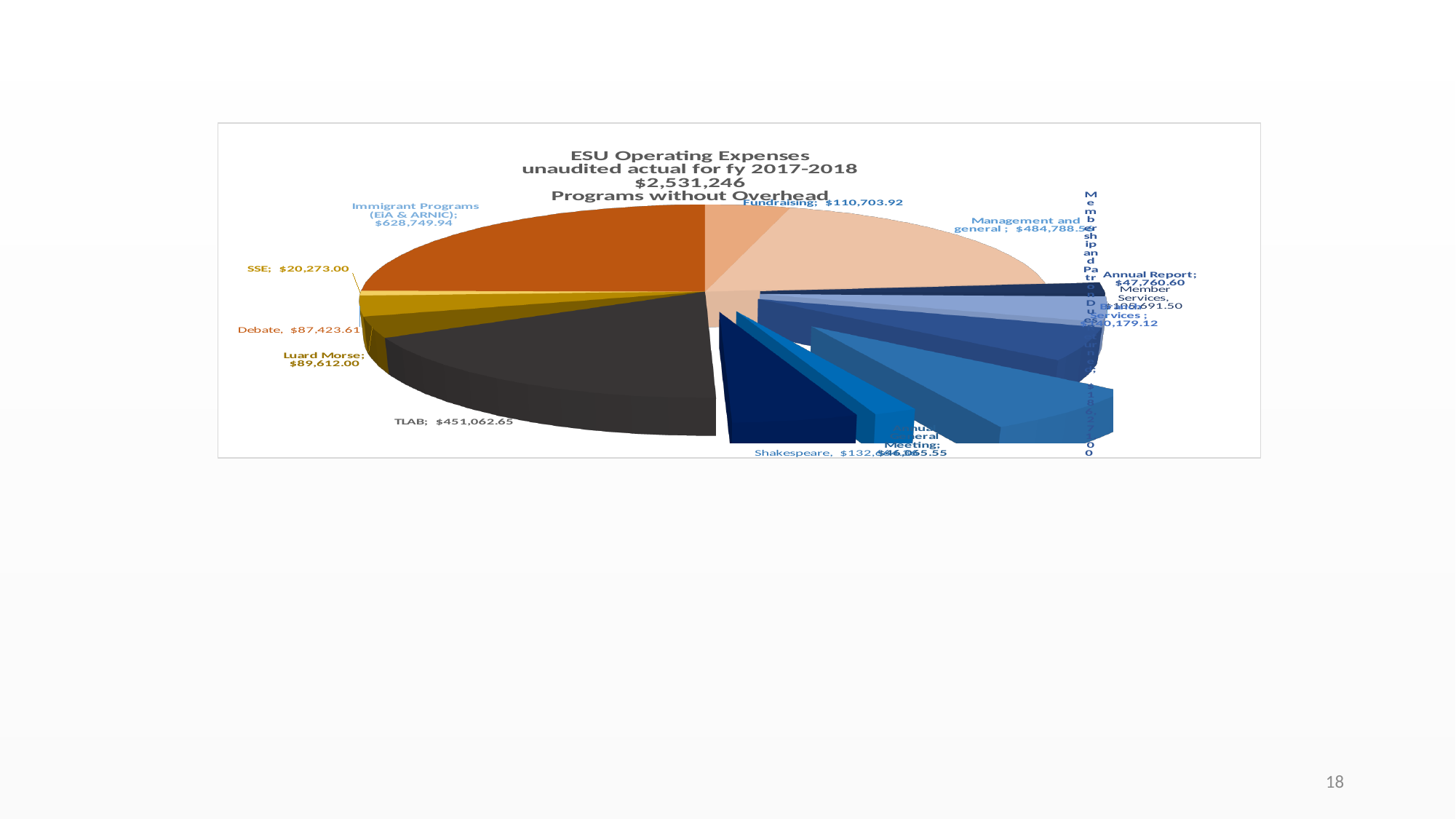
What total amount is stated in the chart title? $2,531,246 What is the value for Annual Report? $47,760.60 What is the value for Luard Morse? $89,612.00 Which category has the largest slice of the pie? Immigrant Programs (EiA & ARNIC) What kind of chart is shown on the slide? Pie chart What is the value for TLAB? $451,062.65 What is the difference between Immigrant Programs (EiA & ARNIC) and TLAB? $177,687.29 What is the value for Debate? $87,423.61 Which is larger, TLAB or Fundraising? TLAB What is the value for Fundraising? $110,703.92 What is the value for Immigrant Programs (EiA & ARNIC)? $628,749.94 What is the value for SSE? $20,273.00